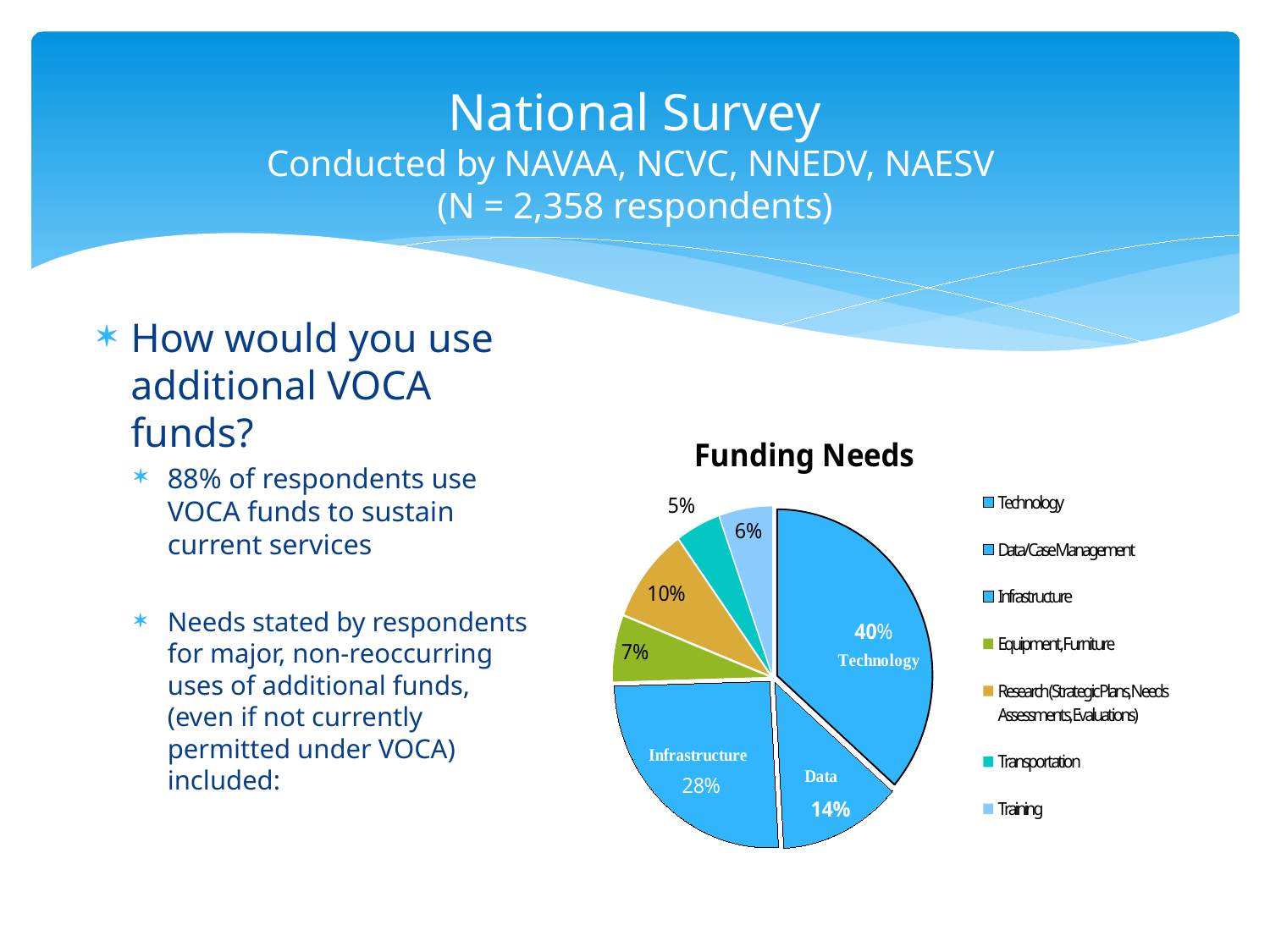
What is the difference between the Technology and Infrastructure shares in the Funding Needs chart? 12% What percentage is shown for Data/Case Management in the Funding Needs chart? 14% Which is larger in the Funding Needs chart, Training or Transportation? Training What is the title of the chart? Funding Needs How many categories does the legend of the Funding Needs chart list? 7 What percentage is shown for Equipment, Furniture in the Funding Needs chart? 7% Which category has the smallest slice in the Funding Needs chart? Transportation What share of the Funding Needs pie is Infrastructure? 28% What share of the Funding Needs pie is Technology? 40% Which category has the largest slice in the Funding Needs chart? Technology What type of chart is shown on the slide? pie chart What percentage is shown for Research (Strategic Plans, Needs Assessments, Evaluations) in the Funding Needs chart? 10%